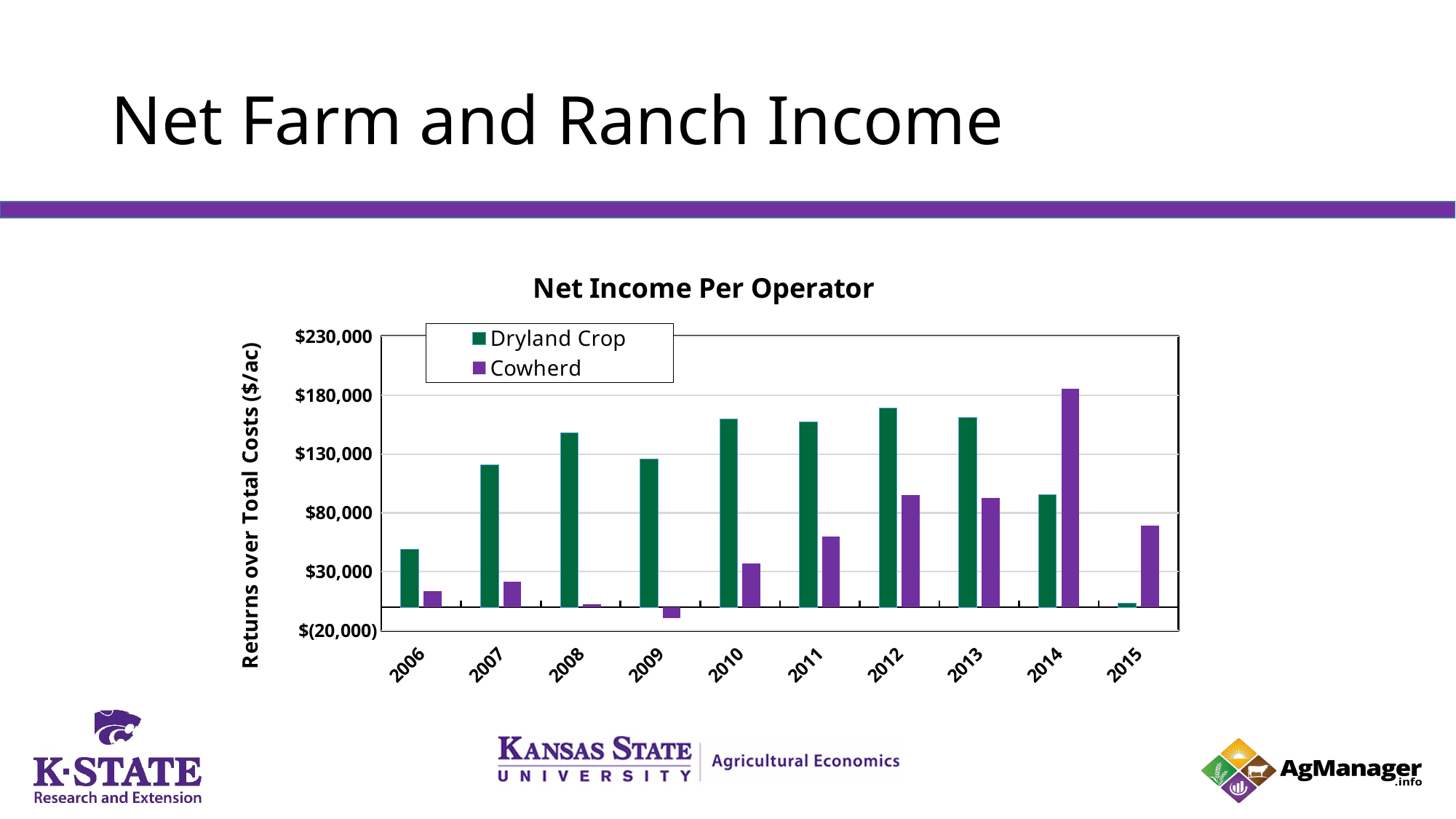
What kind of chart is shown on the slide? bar chart How many series does the legend of the Net Income Per Operator chart list? 2 In which year is the Cowherd value lowest? 2009 Is the Dryland Crop value for 2008 greater or less than $130,000? greater In which year is the Cowherd value highest? 2014 In which year is the Dryland Crop value lowest? 2015 What is the label on the y axis of the Net Income Per Operator chart? Returns over Total Costs ($/ac) In 2007, which series has the larger value, Dryland Crop or Cowherd? Dryland Crop Is the Cowherd value for 2011 greater or less than $80,000? less In 2014, which series has the larger value, Dryland Crop or Cowherd? Cowherd How many years are shown on the x axis of the Net Income Per Operator chart? 10